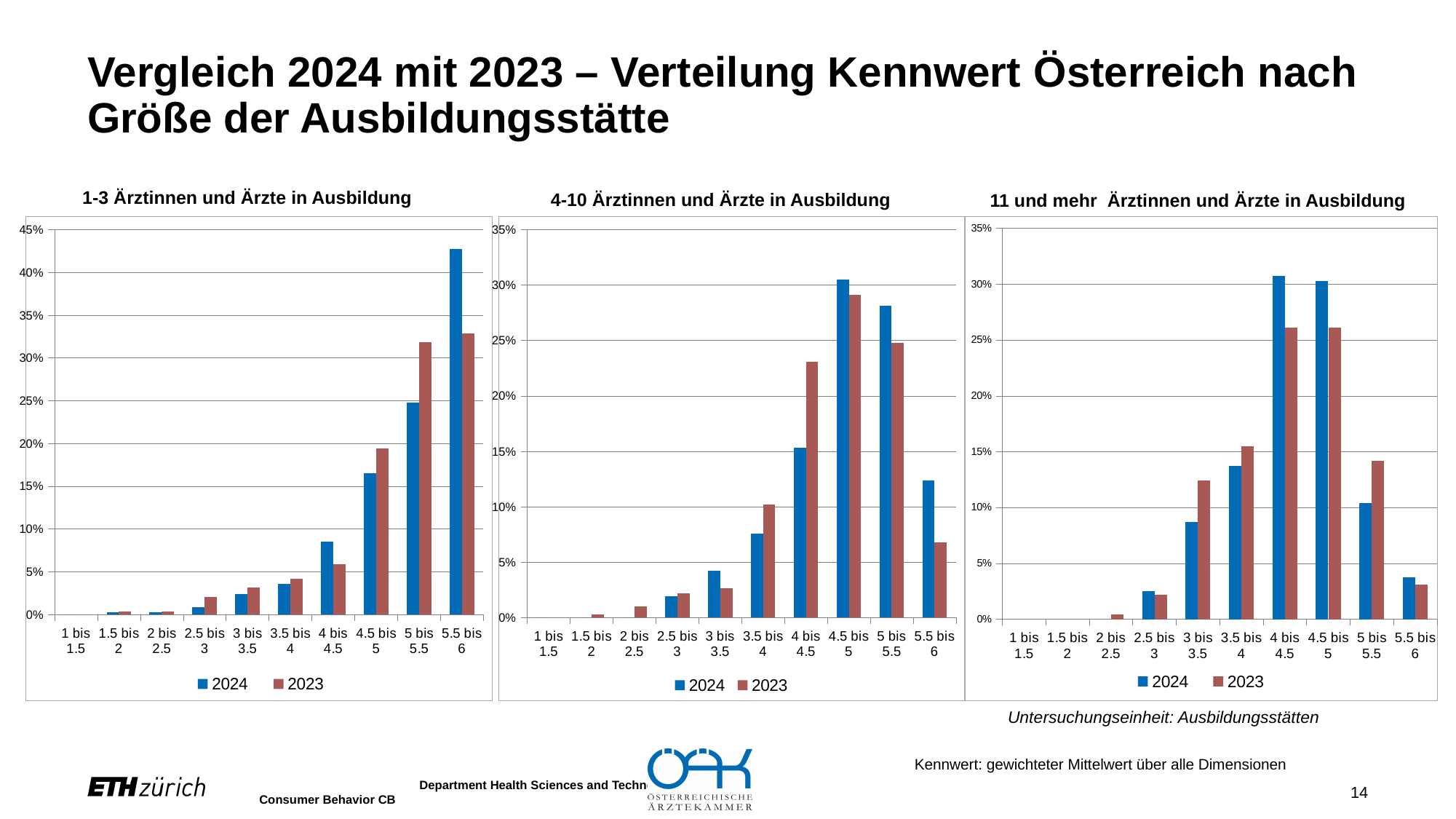
In the chart titled '4-10 Ärztinnen und Ärzte in Ausbildung', how many series does the legend list? 2 In the chart titled '1-3 Ärztinnen und Ärzte in Ausbildung', which category has the highest value for the 2024 series? 5.5 bis 6 In the chart titled '1-3 Ärztinnen und Ärzte in Ausbildung', which is larger for the category '5 bis 5.5': the 2024 value or the 2023 value? 2023 In the chart titled '1-3 Ärztinnen und Ärzte in Ausbildung', is the 2024 value for '5.5 bis 6' greater or less than 40%? greater What kind of chart is the chart titled '11 und mehr Ärztinnen und Ärzte in Ausbildung'? bar chart In the chart titled '11 und mehr Ärztinnen und Ärzte in Ausbildung', which is larger for the category '5 bis 5.5': the 2024 value or the 2023 value? 2023 In the chart titled '1-3 Ärztinnen und Ärzte in Ausbildung', what colour are the bars for the 2024 series? blue In the chart titled '1-3 Ärztinnen und Ärzte in Ausbildung', how many categories are shown on the x axis? 10 In the chart titled '4-10 Ärztinnen und Ärzte in Ausbildung', which category has the highest value for the 2023 series? 4.5 bis 5 In the chart titled '4-10 Ärztinnen und Ärzte in Ausbildung', which is larger for the category '4 bis 4.5': the 2024 value or the 2023 value? 2023 In the chart titled '4-10 Ärztinnen und Ärzte in Ausbildung', is the 2024 value for '5 bis 5.5' greater or less than 25%? greater In the chart titled '11 und mehr Ärztinnen und Ärzte in Ausbildung', is the 2024 value for '3.5 bis 4' greater or less than 15%? less